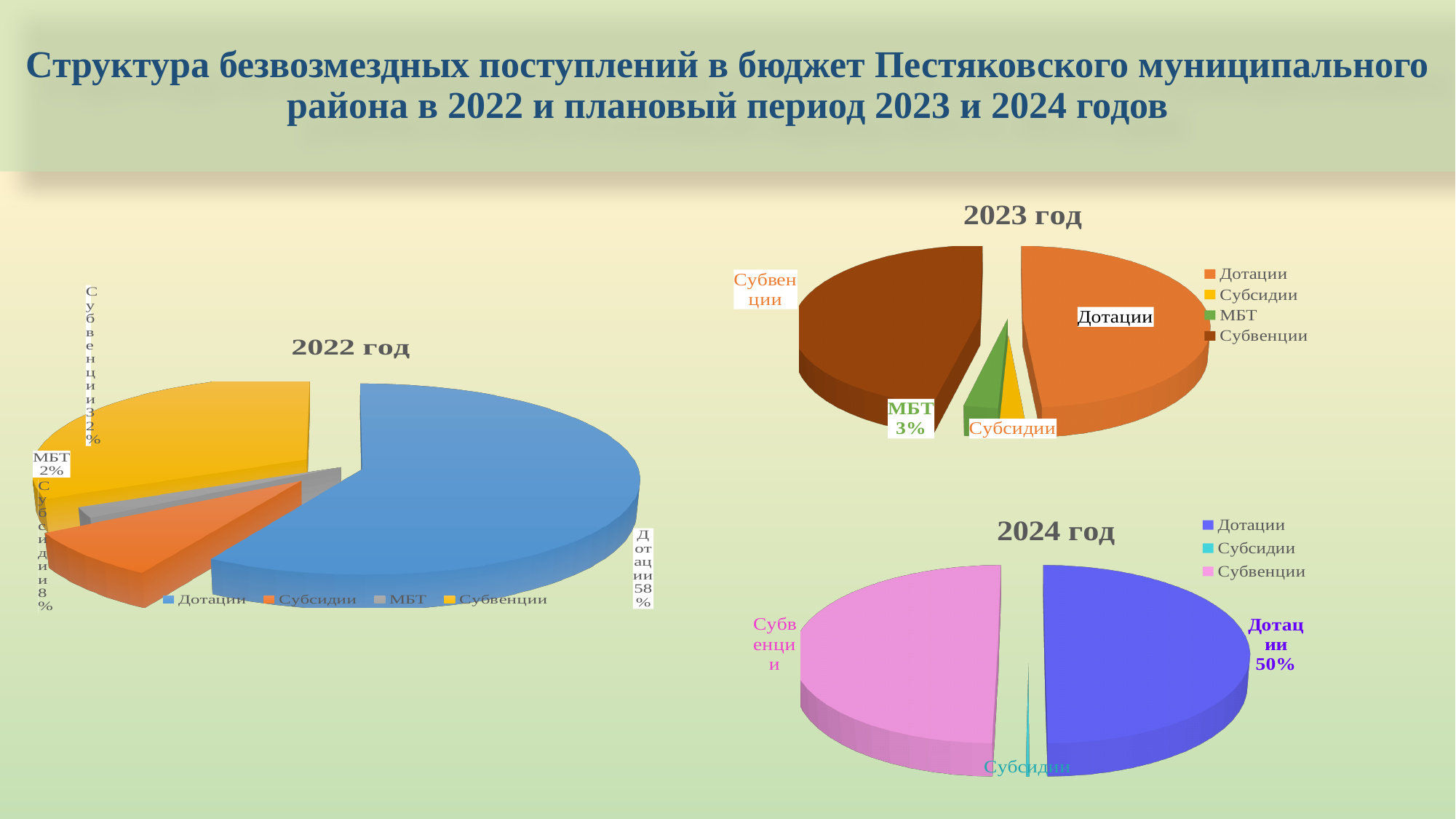
In the 2023 год chart, what share of the pie is МБТ? 3% In the 2022 год chart, by how many percentage points does Дотации exceed Субвенции? 26 How many entries does the legend of the 2023 год chart list? 4 In the 2022 год chart, what share of the pie is МБТ? 2% In the 2022 год chart, what share of the pie is Дотации? 58% In the 2022 год chart, which category has the smallest slice? МБТ In the 2024 год chart, which category has the smallest slice? Субсидии In the 2022 год chart, which category has the largest slice? Дотации In the 2022 год chart, which is larger, Субсидии or МБТ? Субсидии